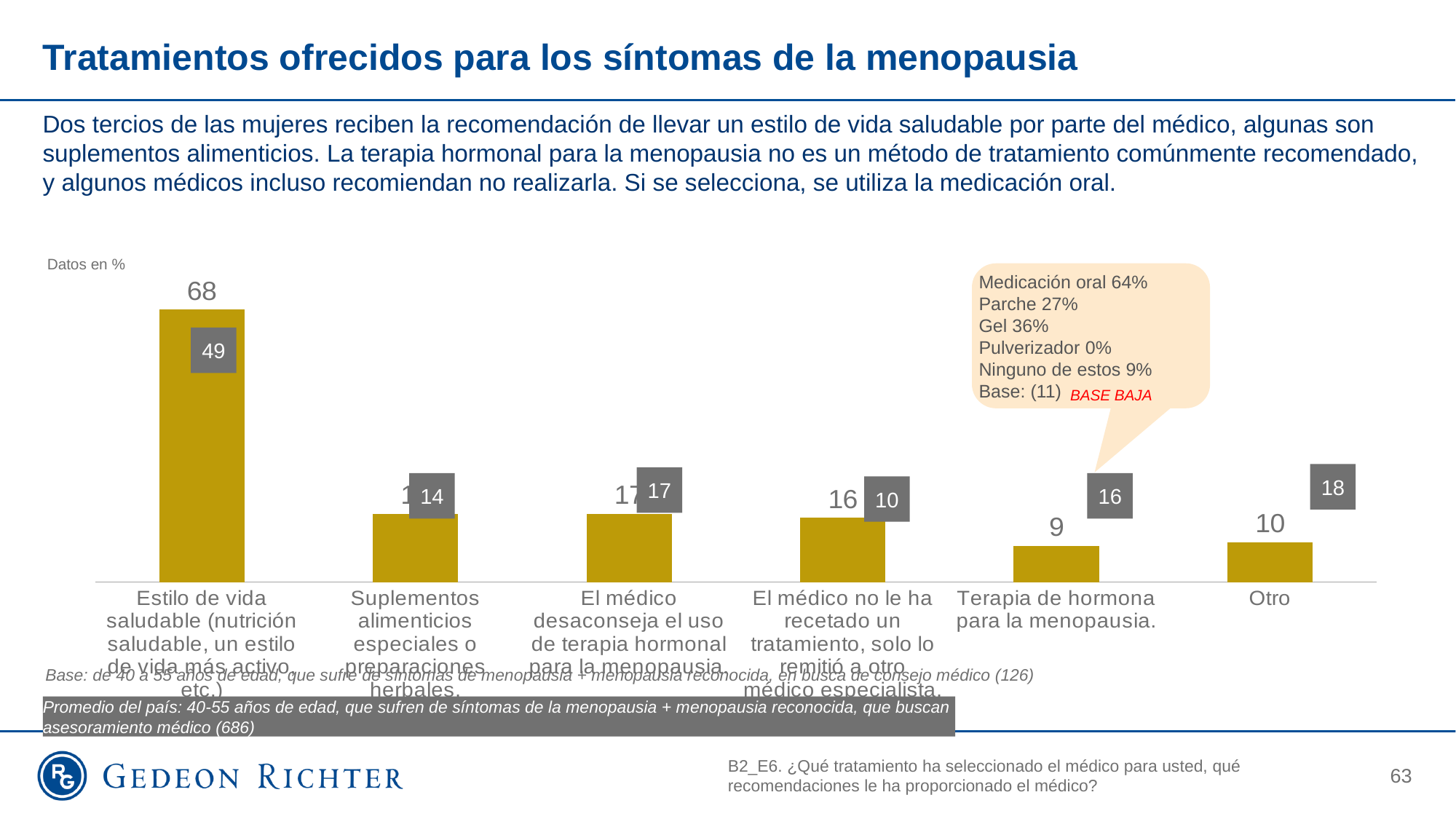
What is the value for 'El médico no le ha recetado un tratamiento, solo lo remitió a otro médico especialista'? 16 Which category has the highest value? Estilo de vida saludable (nutrición saludable, un estilo de vida más activo, etc.) What is the value for 'Terapia de hormona para la menopausia'? 9 What is the value for 'El médico desaconseja el uso de terapia hormonal para la menopausia'? 17 Which is larger: the value for 'El médico desaconseja el uso de terapia hormonal para la menopausia' or the value for 'Otro'? El médico desaconseja el uso de terapia hormonal para la menopausia In the callout box, what percentage is given for 'Medicación oral'? 64% What is the value for 'Estilo de vida saludable (nutrición saludable, un estilo de vida más activo, etc.)'? 68 What is the difference between the value for 'Estilo de vida saludable' and the value for 'Terapia de hormona para la menopausia'? 59 Which category has the lowest value? Terapia de hormona para la menopausia What is the value for 'Otro'? 10 What kind of chart is shown on the slide? Bar chart How many categories are shown on the x axis of the chart? 6